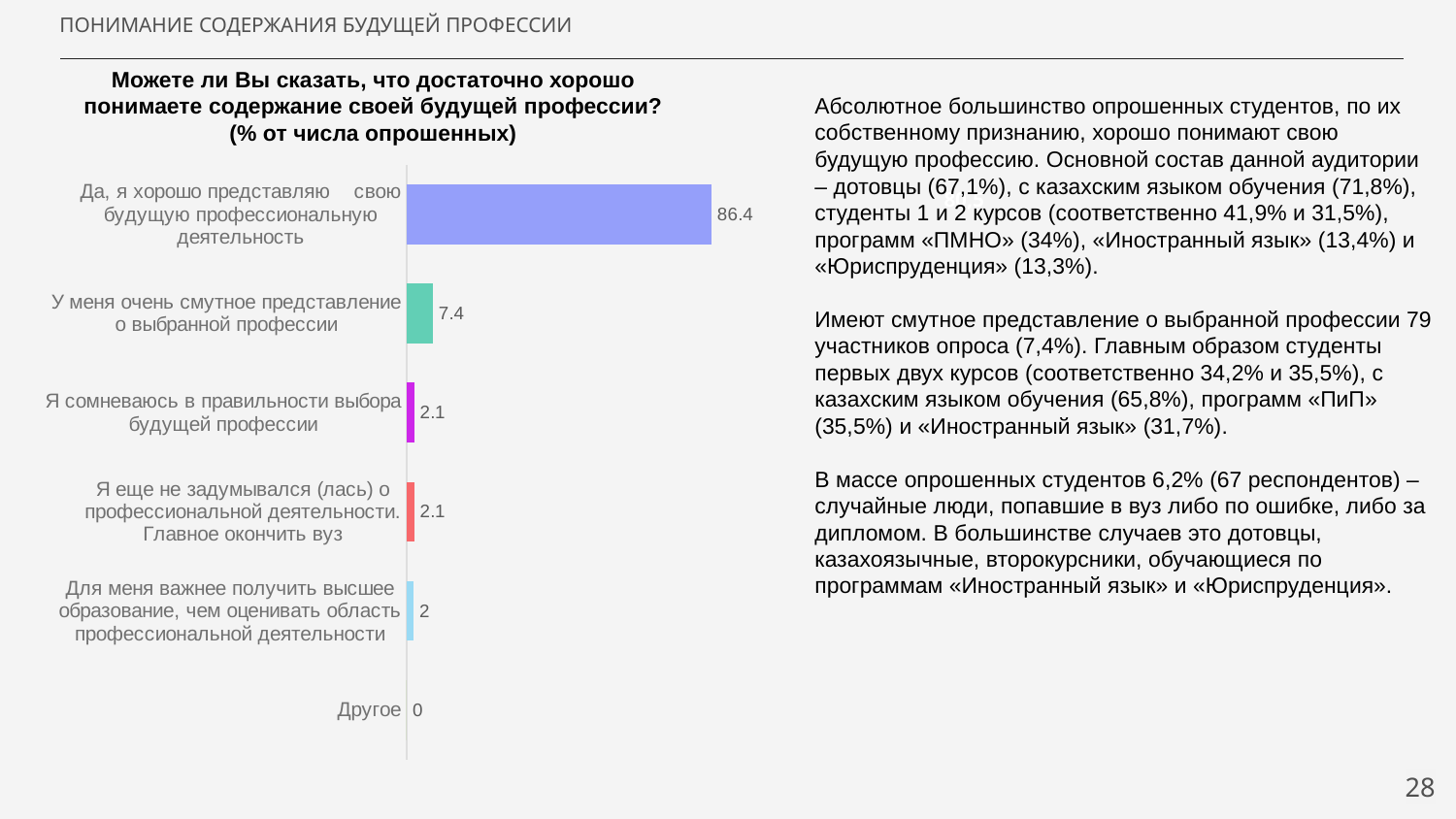
What is the value for "Да, я хорошо представляю свою будущую профессиональную деятельность"? 86.4 What is the difference between the values for "Да, я хорошо представляю свою будущую профессиональную деятельность" and "У меня очень смутное представление о выбранной профессии"? 79 What is the value for "Для меня важнее получить высшее образование, чем оценивать область профессиональной деятельности"? 2 What is the title of the chart? Можете ли Вы сказать, что достаточно хорошо понимаете содержание своей будущей профессии? (% от числа опрошенных) What is the value for "Другое"? 0 How many categories are shown in the chart? 6 Which category has the lowest value? Другое What type of chart is shown on the slide? Bar chart Which category has the highest value? Да, я хорошо представляю свою будущую профессиональную деятельность What is the value for "У меня очень смутное представление о выбранной профессии"? 7.4 Which is larger: the value for "У меня очень смутное представление о выбранной профессии" or the value for "Я сомневаюсь в правильности выбора будущей профессии"? У меня очень смутное представление о выбранной профессии What is the value for "Я сомневаюсь в правильности выбора будущей профессии"? 2.1